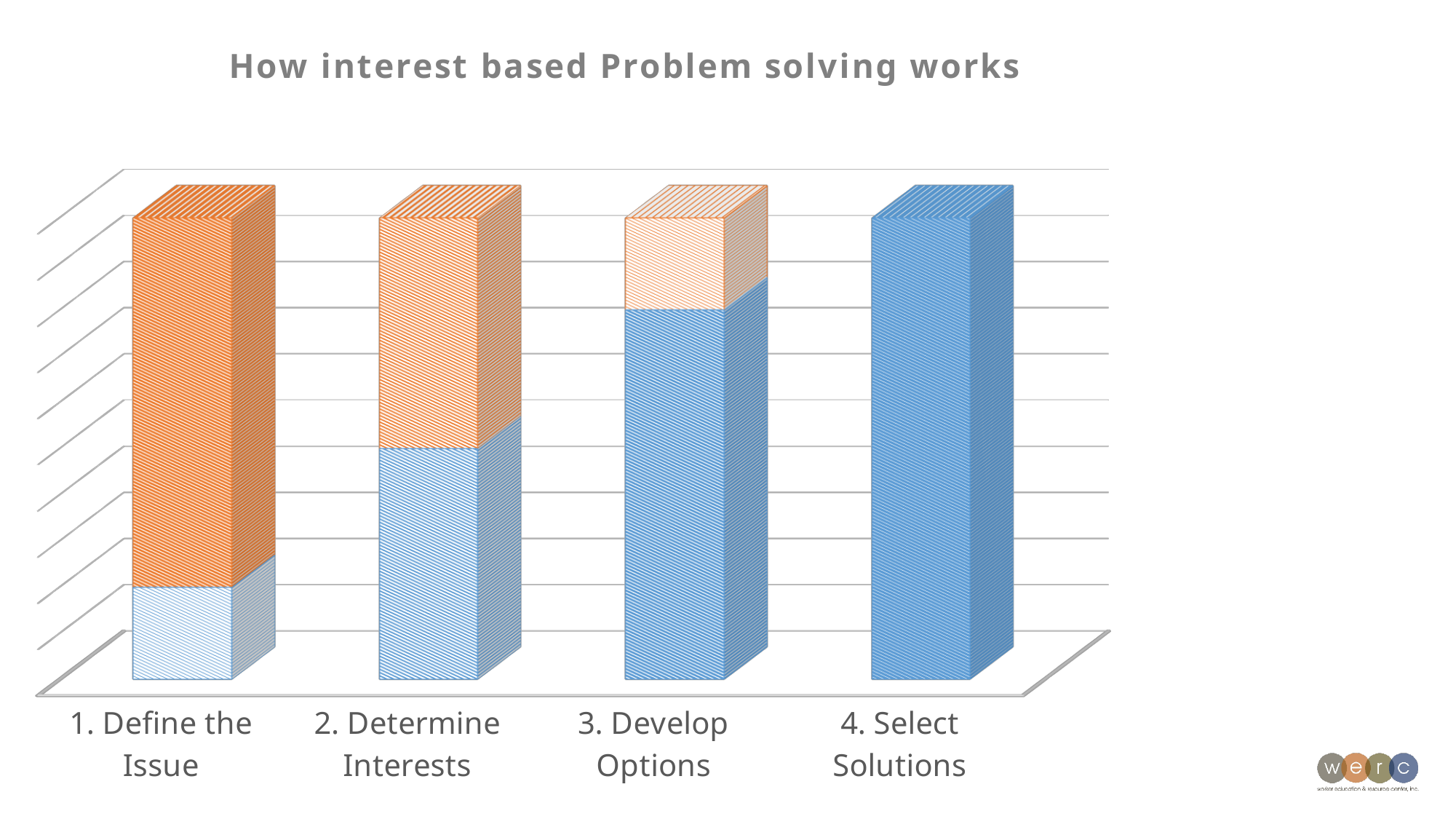
How many categories are shown along the x axis of the chart? 4 What kind of chart is shown on the slide? Stacked bar chart Is the orange portion larger for 1. Define the Issue or for 2. Determine Interests? 1. Define the Issue Does the blue portion of the bars rise or fall from left to right across the categories? Rise Is the blue portion larger for 2. Determine Interests or for 3. Develop Options? 3. Develop Options Which category's bar contains no orange portion at all? 4. Select Solutions Which category has the smallest blue portion in its bar? 1. Define the Issue What is the title of the chart? How interest based Problem solving works Does the orange portion of the bars rise or fall from left to right across the categories? Fall Which category has the largest blue portion in its bar? 4. Select Solutions What is the label of the third category on the x axis? 3. Develop Options Which category has the largest orange portion in its bar? 1. Define the Issue